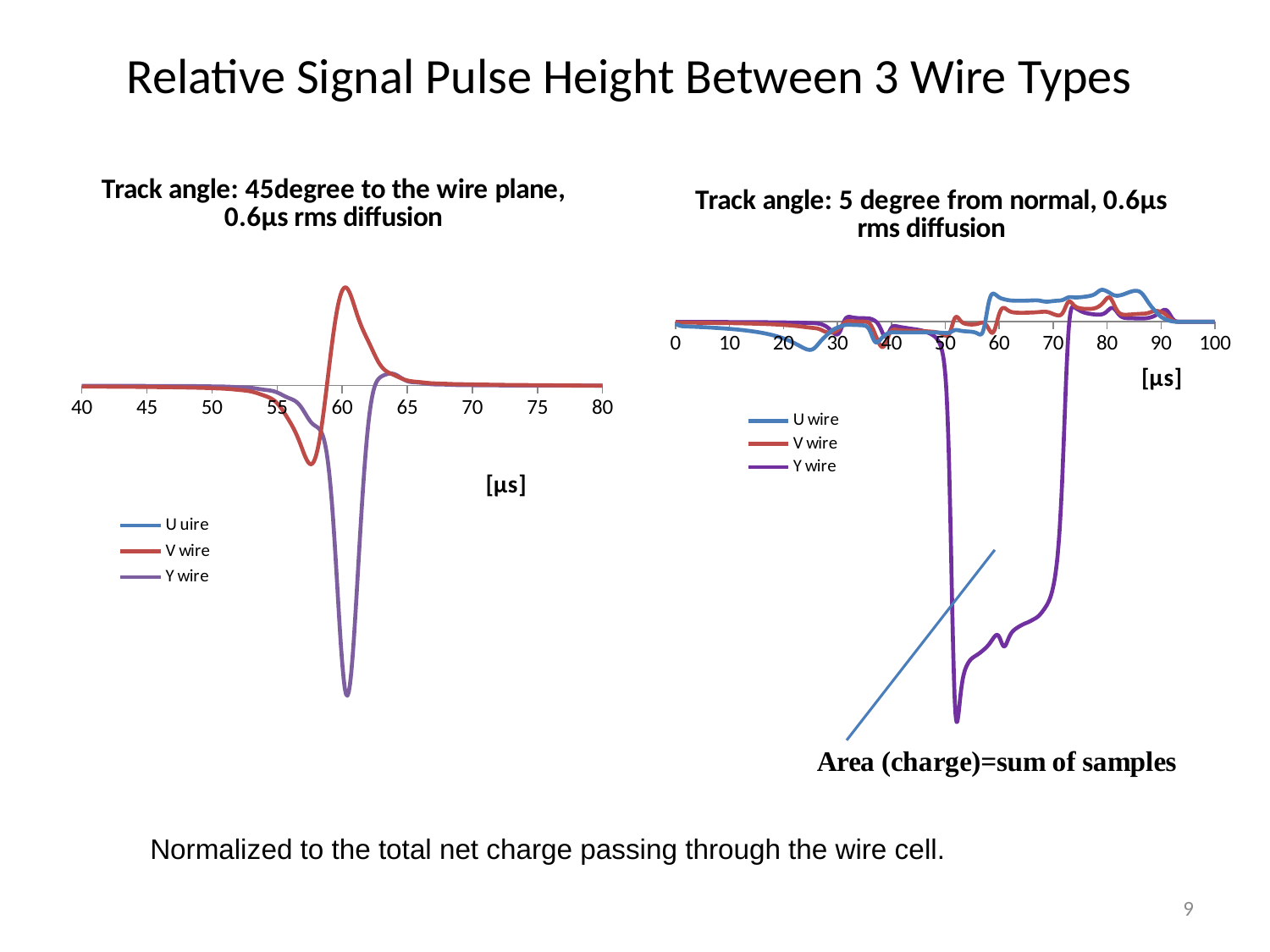
How many series does the legend of the right chart list? 3 What kind of chart is the right chart (Track angle: 5 degree from normal)? line chart In the left chart, is the Y wire minimum located at an x value greater or less than 55? greater How many series does the legend of the left chart list? 3 In the right chart, is the Y wire minimum located at an x value greater or less than 60? less What is the title of the right chart? Track angle: 5 degree from normal, 0.6μs rms diffusion In the left chart, which series reaches the lowest (most negative) value? Y wire What is the largest x-axis tick value on the right chart? 100 What unit is shown on the x axis of both charts? [μs] In the right chart, which series reaches the lowest (most negative) value? Y wire In the left chart, which series reaches the highest positive peak? V wire What kind of chart is the left chart (Track angle: 45degree to the wire plane)? line chart